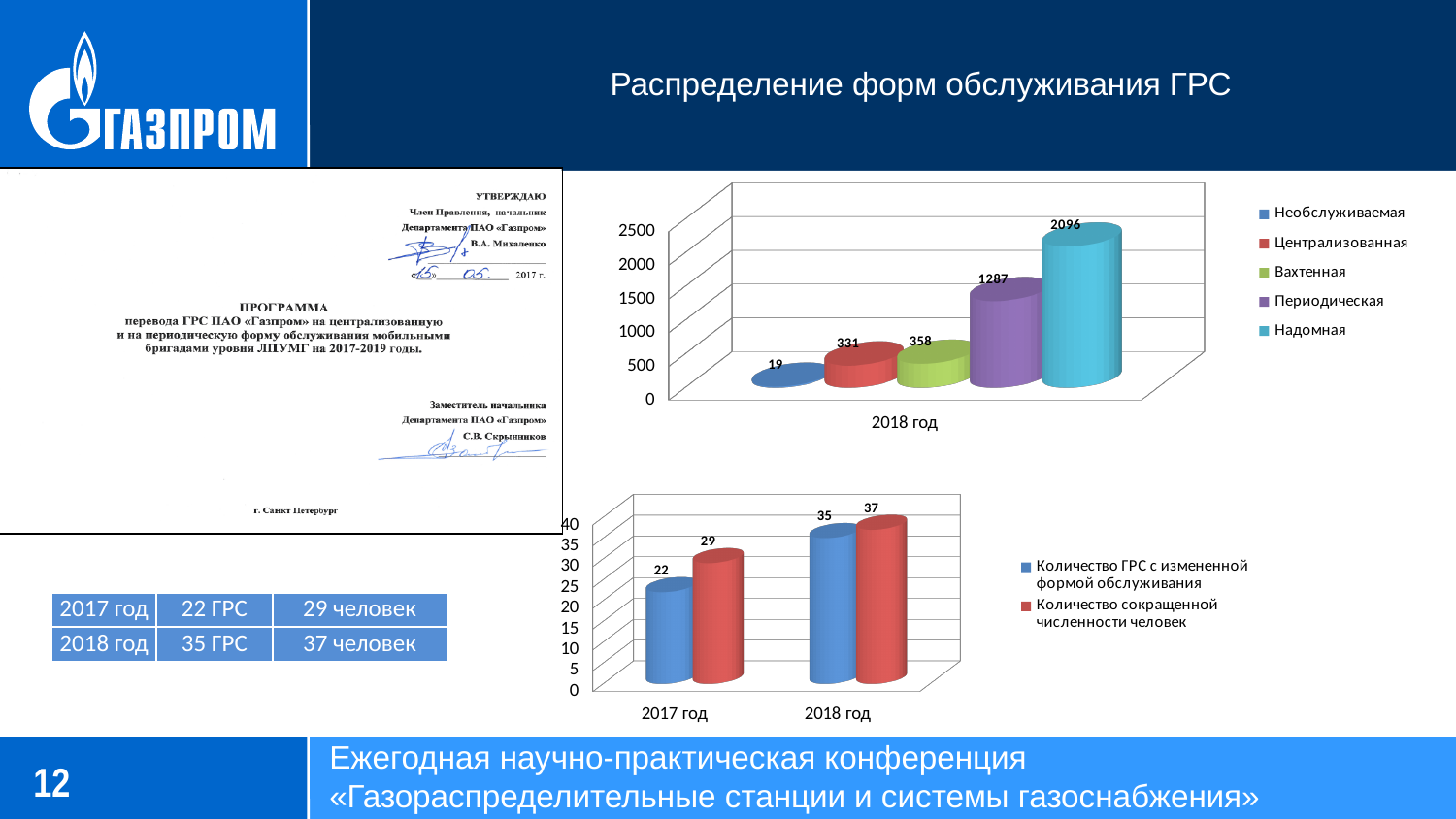
In the top chart (2018 год), what is the value for Периодическая? 1287 In the top chart (2018 год), what is the value for Надомная? 2096 In the bottom chart, what is the value of Количество сокращенной численности человек for 2017 год? 29 What kind of chart is the bottom chart? bar chart In the top chart (2018 год), which form of service has the lowest value? Необслуживаемая In the bottom chart, does Количество ГРС с измененной формой обслуживания rise or fall from 2017 год to 2018 год? rise In the top chart (2018 год), what is the difference between Надомная and Периодическая? 809 In the bottom chart, what is the value of Количество ГРС с измененной формой обслуживания for 2018 год? 35 In the top chart (2018 год), how many series does the legend list? 5 In the top chart (2018 год), which form of service has the highest value? Надомная In the bottom chart, what is the difference between Количество сокращенной численности человек in 2018 год and 2017 год? 8 In the top chart (2018 год), is the value for Централизованная greater or less than 500? less